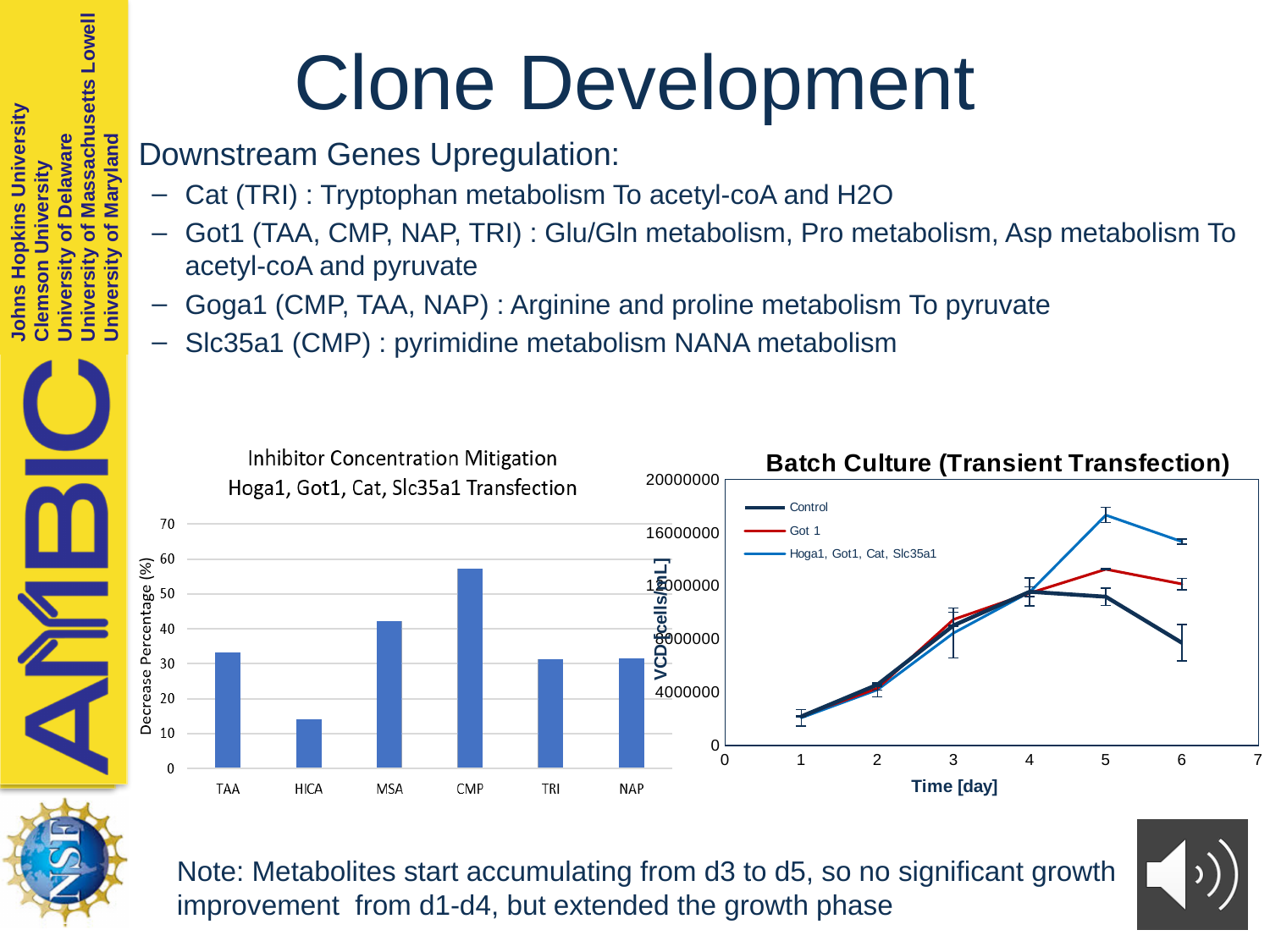
How many categories are shown on the x axis of the 'Inhibitor Concentration Mitigation' bar chart? 6 In the 'Inhibitor Concentration Mitigation' bar chart, is the value for CMP greater or less than 50? greater What kind of chart is the 'Batch Culture (Transient Transfection)' chart on the right? line chart In the 'Batch Culture (Transient Transfection)' chart, which series has the highest value at day 5? Hoga1, Got1, Cat, Slc35a1 In the 'Batch Culture (Transient Transfection)' chart, does the Control series rise or fall from day 5 to day 6? fall In the 'Inhibitor Concentration Mitigation' bar chart, which category has the lowest decrease percentage? HICA How many series does the legend of the 'Batch Culture (Transient Transfection)' chart list? 3 What kind of chart is the 'Inhibitor Concentration Mitigation' chart on the left? bar chart What is the y-axis label of the 'Inhibitor Concentration Mitigation' bar chart? Decrease Percentage (%) In the 'Inhibitor Concentration Mitigation' bar chart, which category has the highest decrease percentage? CMP In the 'Inhibitor Concentration Mitigation' bar chart, is the value for HICA greater or less than 20? less In the 'Inhibitor Concentration Mitigation' bar chart, which is larger, the value for MSA or the value for TAA? MSA